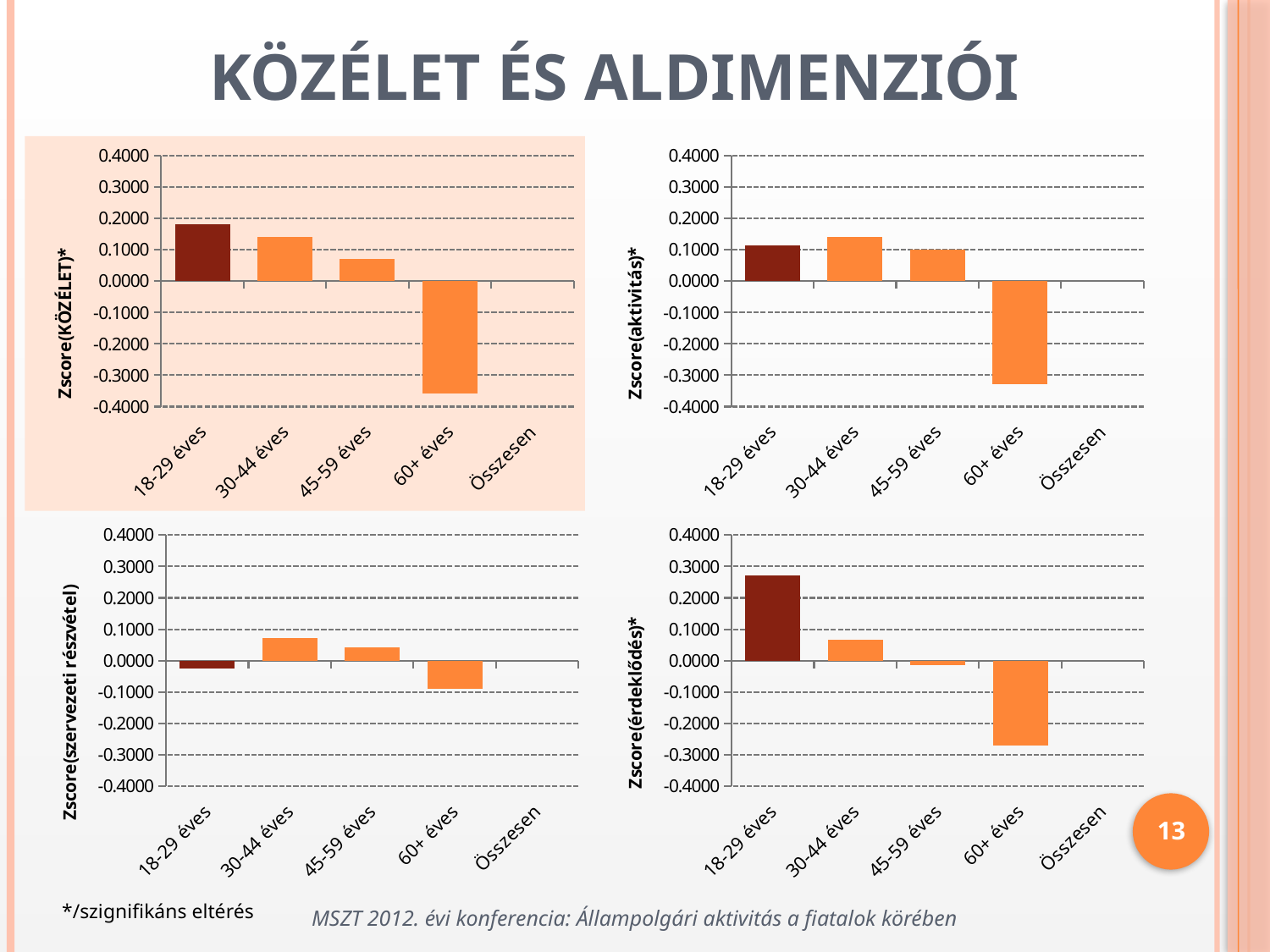
In the Zscore(aktivitás)* chart, is the value for 60+ éves greater or less than -0.3000? less In the Zscore(érdeklődés)* chart, is the value for 18-29 éves greater or less than 0.2000? greater In the Zscore(KÖZÉLET)* chart, which age group has the lowest value? 60+ éves In the Zscore(KÖZÉLET)* chart, is the value for 60+ éves greater or less than -0.3000? less How many age categories are shown on the x axis of the Zscore(aktivitás)* chart? 4 What kind of chart is the top-left chart labelled Zscore(KÖZÉLET)*? bar chart In the Zscore(KÖZÉLET)* chart, do the values rise or fall from 18-29 éves to 60+ éves? fall In the Zscore(érdeklődés)* chart, which is larger, the value for 18-29 éves or the value for 30-44 éves? 18-29 éves In the Zscore(KÖZÉLET)* chart, which age group has the highest value? 18-29 éves What is the title of the slide containing the four charts? KÖZÉLET ÉS ALDIMENZIÓI In the Zscore(aktivitás)* chart, which age group has the highest value? 30-44 éves In the Zscore(szervezeti részvétel) chart, which age group has the highest value? 30-44 éves